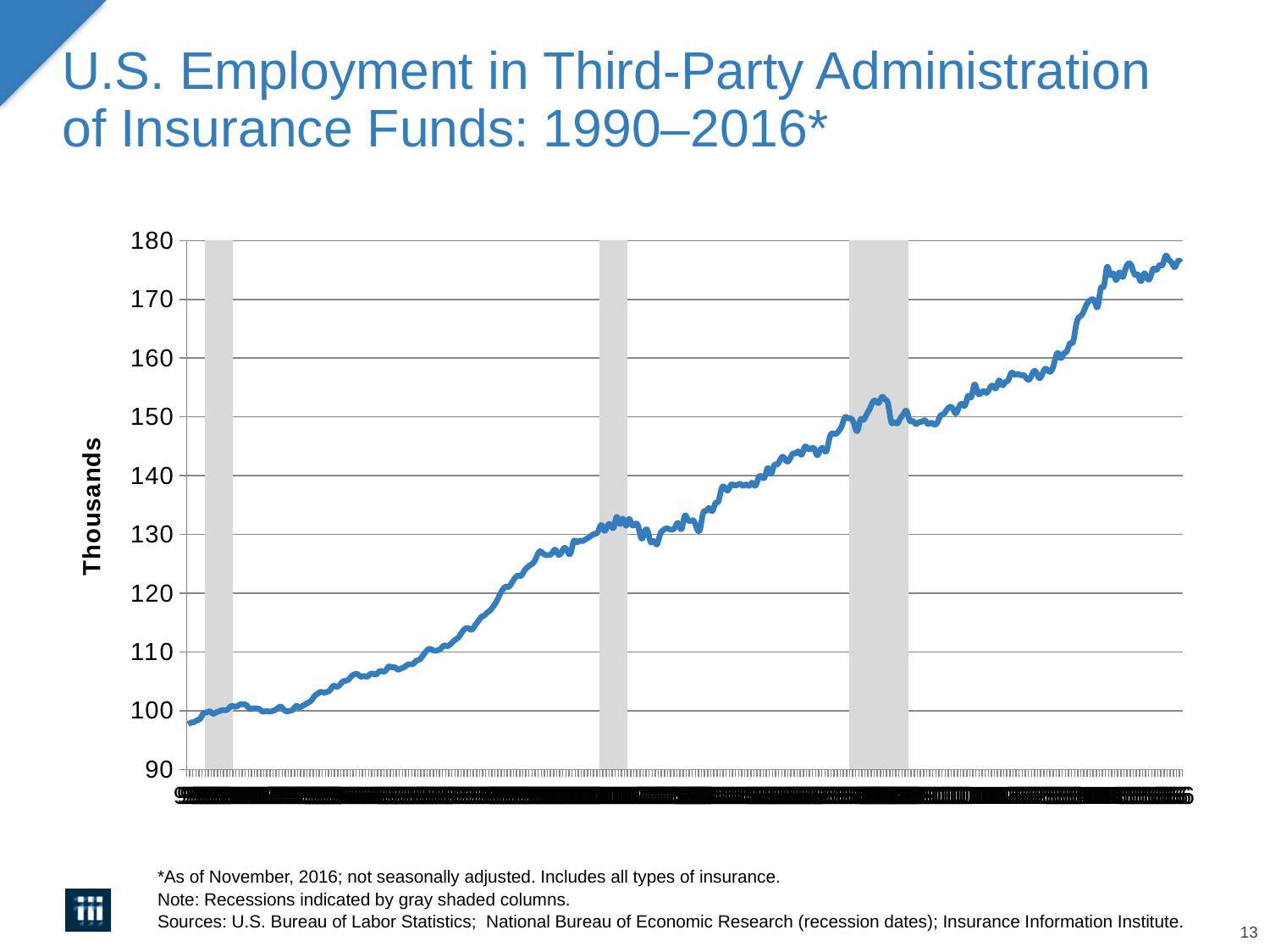
Is the value at the left-hand start of the line greater or less than 110? less Is the value at the right-hand end of the line greater or less than 170? greater Is the value at the right-hand end of the line greater or less than 180? less Which is larger, the value at the start of the line or the value at the end of the line? the value at the end What is the label on the vertical axis? Thousands What is the highest value shown on the vertical axis? 180 What is the lowest value shown on the vertical axis? 90 How many gray shaded recession columns are shown on the chart? 3 What kind of chart is shown on the slide? line chart Overall, do the values rise or fall from left to right along the x axis? rise